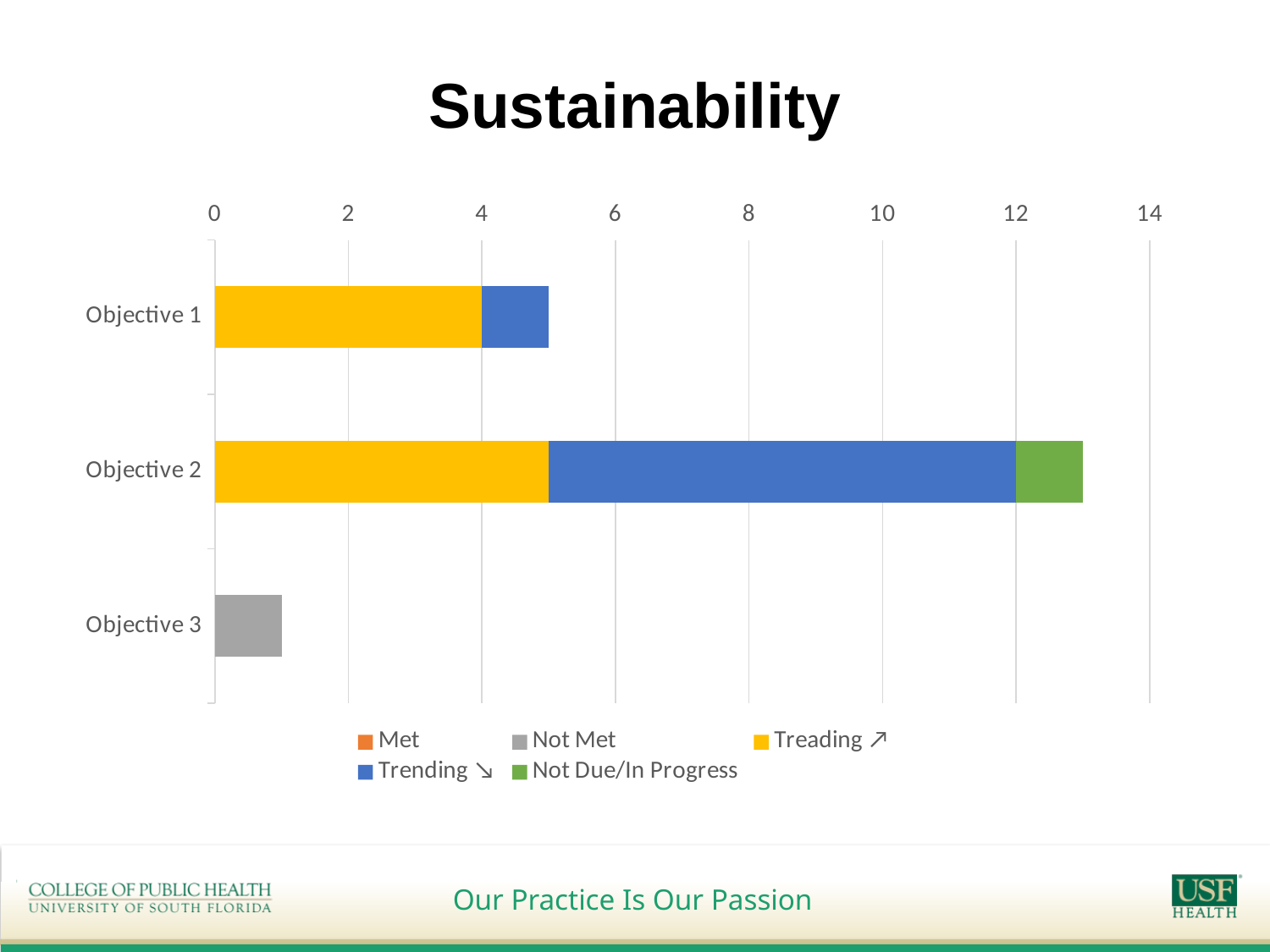
Is the total value for Objective 1 greater or less than 6? less Which has a larger total bar, Objective 1 or Objective 2? Objective 2 What is the title of the chart? Sustainability Which legend series is the only one shown for Objective 3? Not Met How many series does the legend list? 5 What kind of chart is shown on the slide? Stacked bar chart What is the Treading ↗ value for Objective 1? 4 Which objective has the longest total bar? Objective 2 Is the value for Objective 3 greater or less than 2? less Is the total value for Objective 2 greater or less than 12? greater Which objective has the shortest total bar? Objective 3 How many objectives (categories) are plotted on the chart? 3